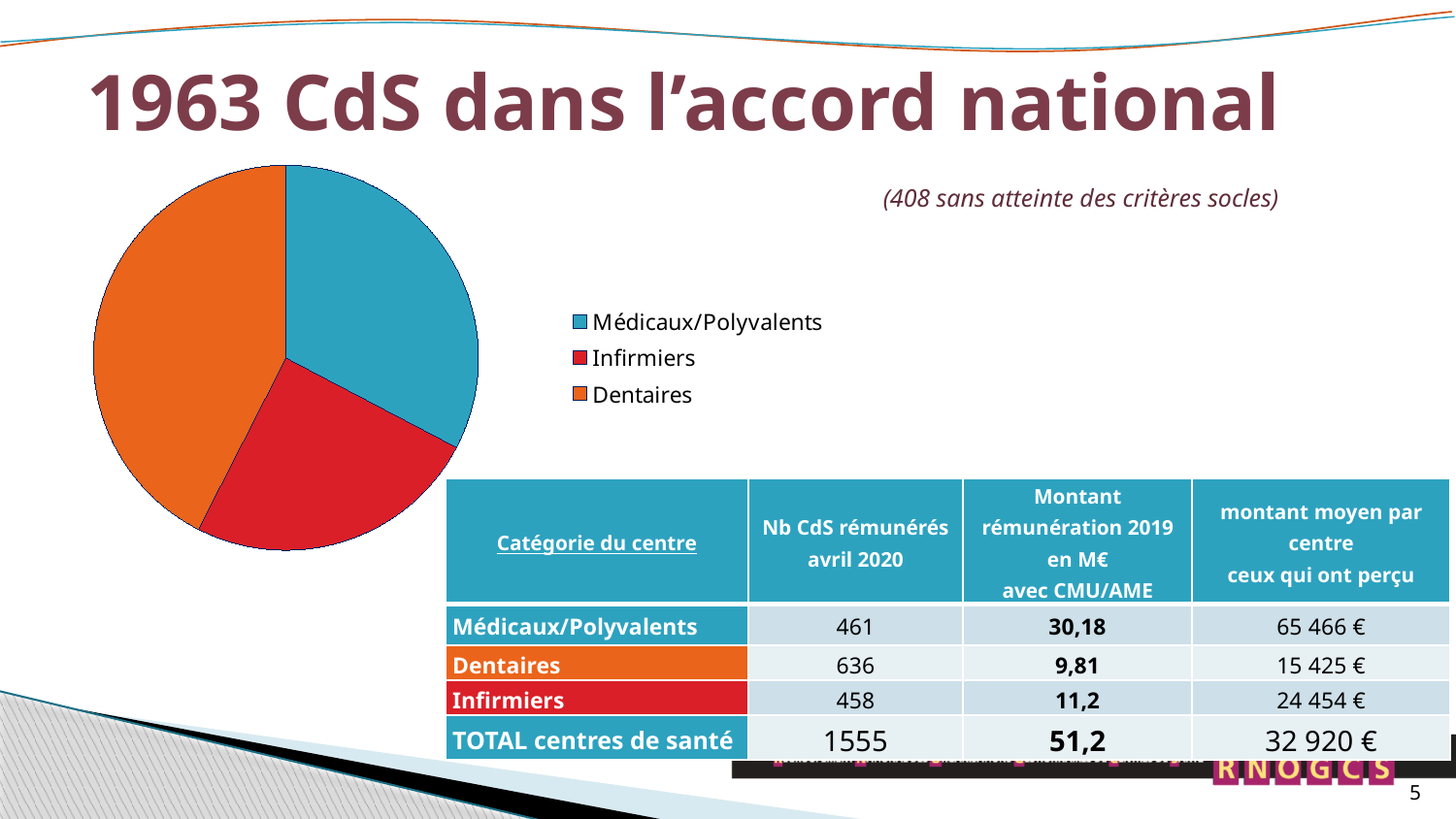
In the pie chart, which slice is larger: Dentaires or Infirmiers? Dentaires How many entries does the pie chart's legend list? 3 In the pie chart, which slice is larger: Médicaux/Polyvalents or Infirmiers? Médicaux/Polyvalents What kind of chart is shown on the slide? pie chart Which colour represents Dentaires in the pie chart? orange How many slices does the pie chart have? 3 Which category is shown in blue in the pie chart? Médicaux/Polyvalents Which category has the smallest slice in the pie chart? Infirmiers